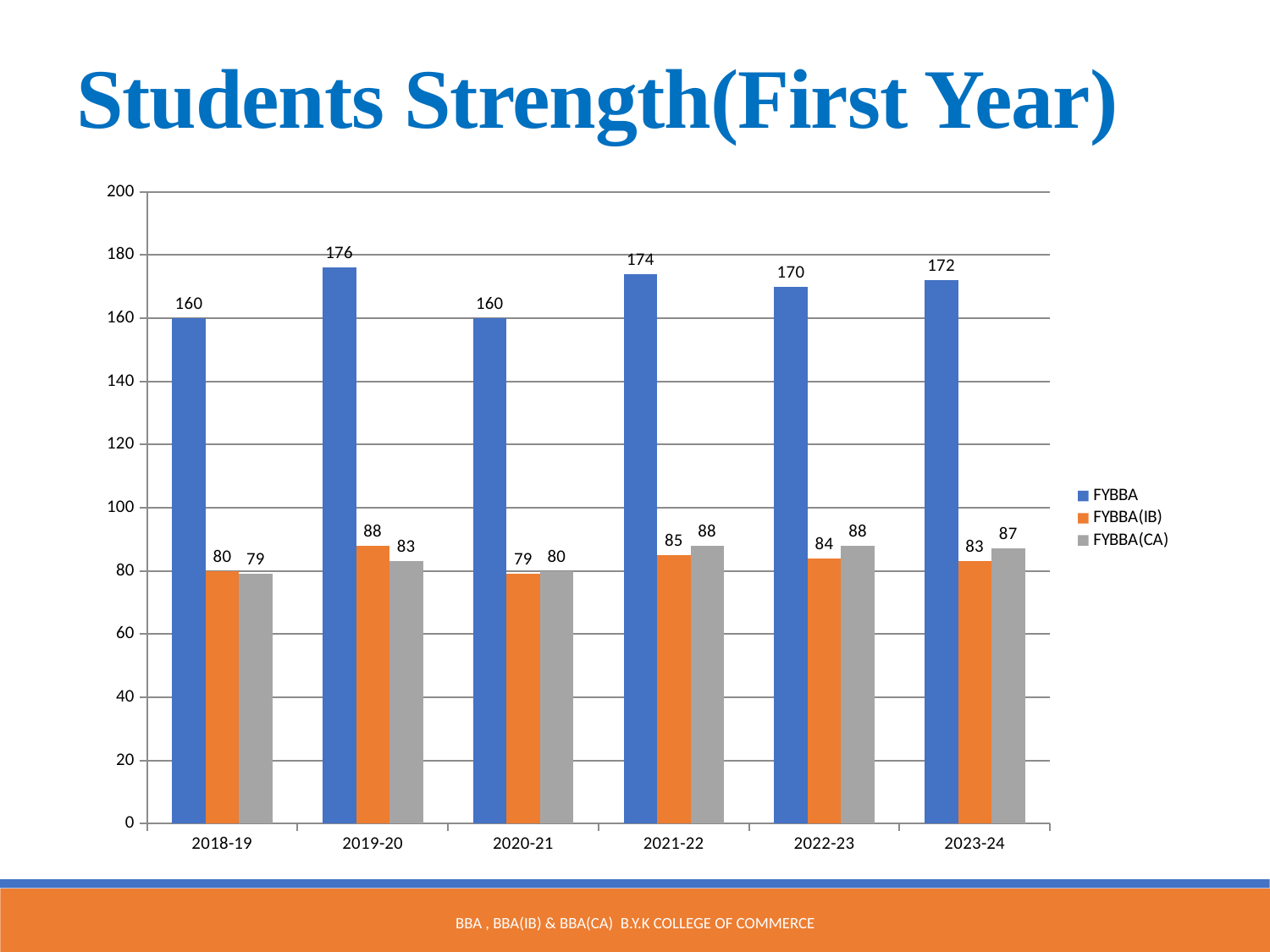
What kind of chart is shown on the slide? bar chart How many academic years are shown on the x axis? 6 What is the FYBBA value for 2019-20? 176 In which year is the FYBBA value highest? 2019-20 Is the FYBBA value for 2022-23 greater or less than 160? greater How many series does the legend list? 3 What is the FYBBA(CA) value for 2023-24? 87 What is the FYBBA(IB) value for 2021-22? 85 In which year is the FYBBA(IB) value lowest? 2020-21 Which series is shown in orange in the legend? FYBBA(IB) What is the difference between the FYBBA values for 2019-20 and 2018-19? 16 Which is larger in 2022-23: FYBBA(IB) or FYBBA(CA)? FYBBA(CA)